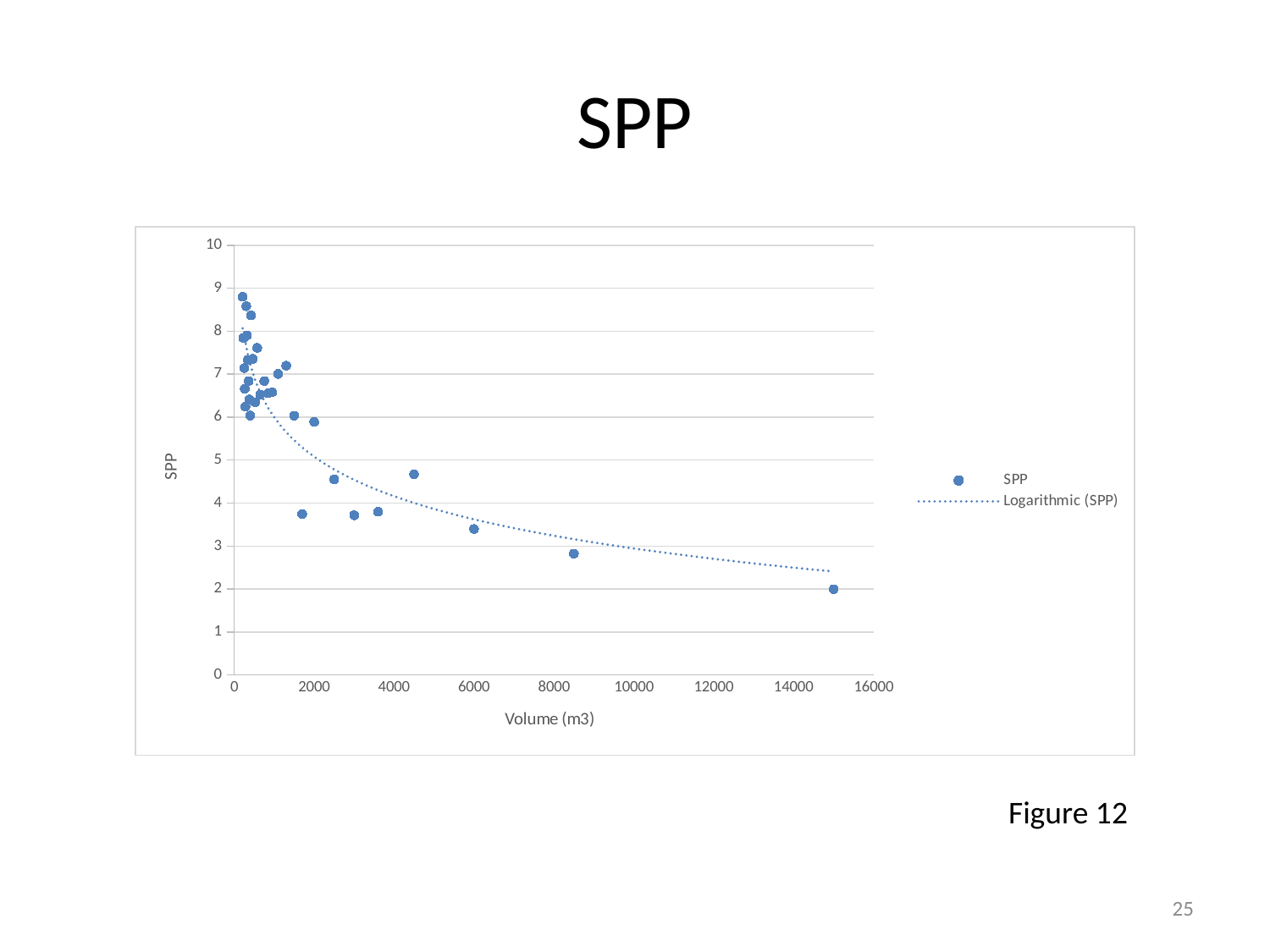
What are the two entries in the chart legend? SPP and Logarithmic (SPP) What is the title of the x axis of the chart? Volume (m3) What is the highest value shown on the y axis of the chart? 10 Does the point with the lowest SPP value have the largest or the smallest volume on the chart? largest Is the SPP value of the point near 8500 m3 greater or less than 4? less As volume increases along the x axis, do the SPP values generally rise or fall? fall What kind of chart is shown on the slide? scatter chart Is the SPP value of the point at the largest volume (near 15000 m3) greater or less than 3? less Is the SPP value of the point near 6000 m3 greater or less than 4? less How many entries does the chart legend list? 2 Which has the higher SPP value: the point near 4500 m3 or the point near 8500 m3? the point near 4500 m3